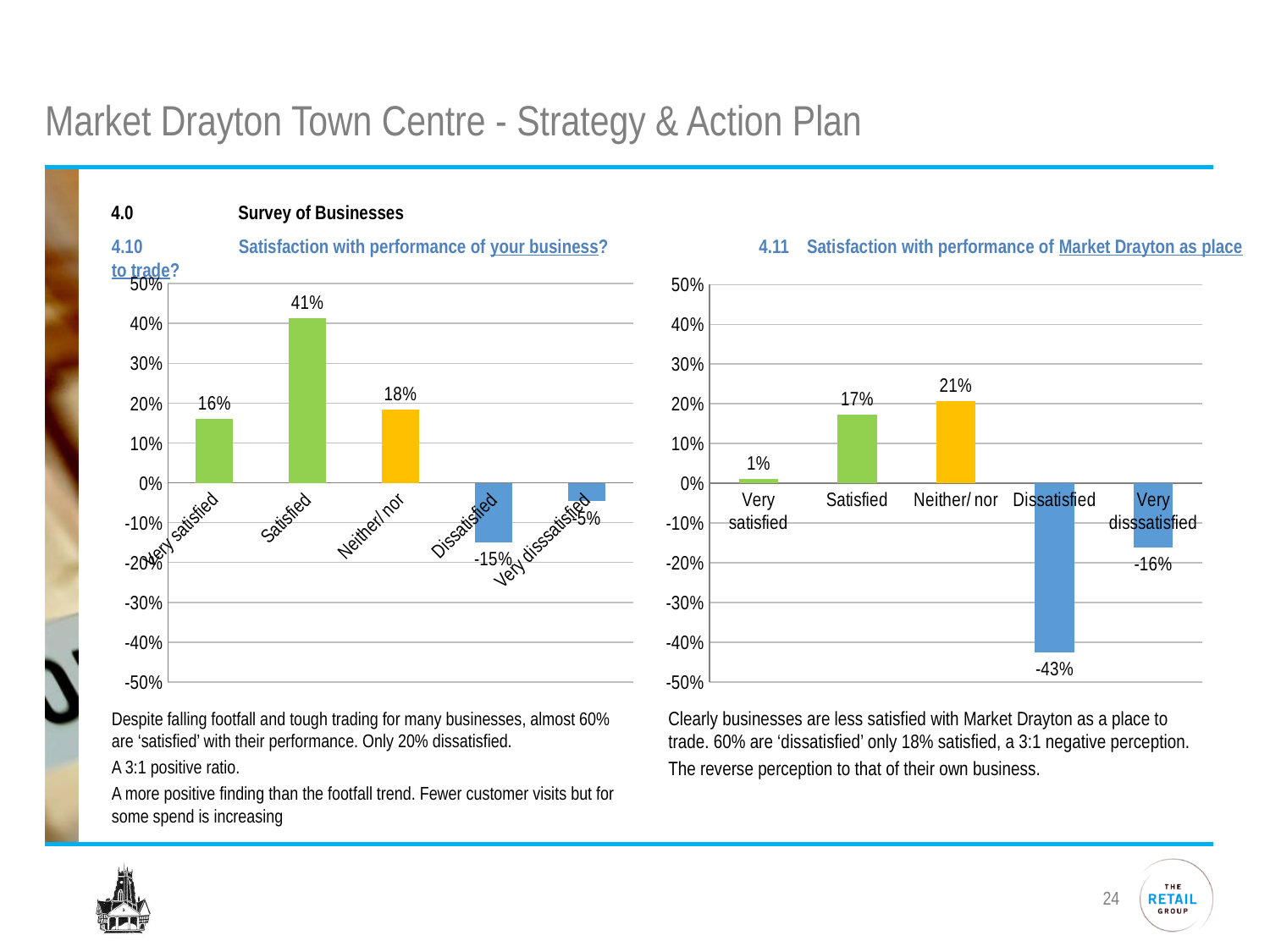
In the right chart (Satisfaction with performance of Market Drayton as place to trade), what is the value for Dissatisfied? -43% In the right chart (Satisfaction with performance of Market Drayton as place to trade), what is the difference between the Satisfied and Very satisfied values? 16% In the right chart (Satisfaction with performance of Market Drayton as place to trade), which is larger, the value for Satisfied or the value for Neither/nor? Neither/nor In the left chart (Satisfaction with performance of your business), what is the value for Dissatisfied? -15% What type of chart is the left chart (Satisfaction with performance of your business)? Bar chart In the right chart (Satisfaction with performance of Market Drayton as place to trade), which category has the lowest value? Dissatisfied In the left chart (Satisfaction with performance of your business), which category has the highest value? Satisfied In the left chart (Satisfaction with performance of your business), what is the difference between the Satisfied and Neither/nor values? 23% In the right chart (Satisfaction with performance of Market Drayton as place to trade), what is the value for Neither/nor? 21% How many categories are shown in the right chart (Satisfaction with performance of Market Drayton as place to trade)? 5 In the left chart (Satisfaction with performance of your business), what is the value for Very satisfied? 16% In the left chart (Satisfaction with performance of your business), what is the value for Satisfied? 41%